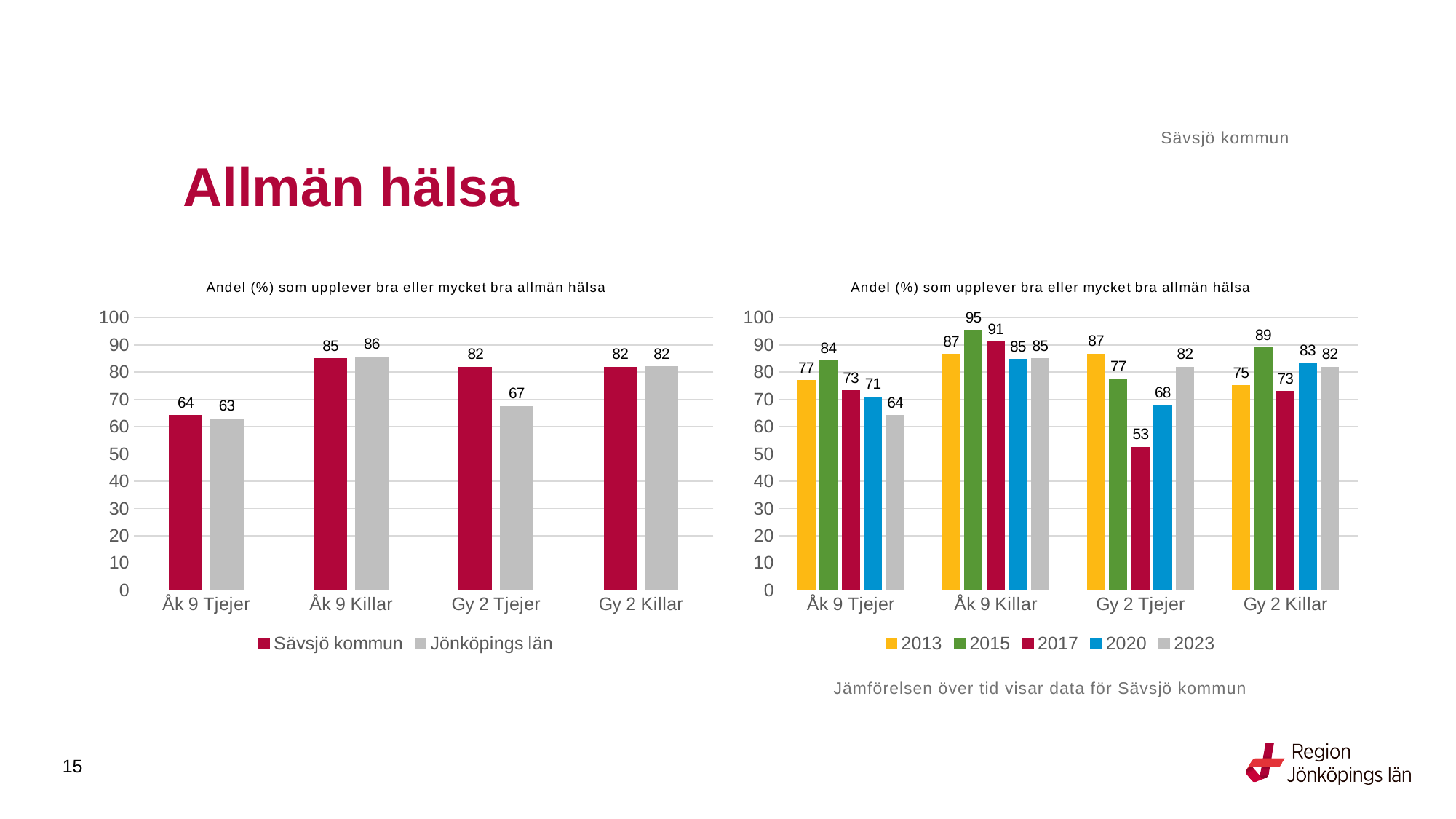
In the left chart, how many series does the legend list? 2 In the left chart, what is the value for Jönköpings län for Gy 2 Tjejer? 67 In the right chart, what is the difference between the 2013 and 2023 values for Gy 2 Tjejer? 5 In the left chart, which category has the lowest value for Sävsjö kommun? Åk 9 Tjejer In the right chart, what is the value for 2017 for Gy 2 Tjejer? 53 In the right chart, how many series does the legend list? 5 In the right chart, which is larger for Åk 9 Tjejer: the value for 2013 or the value for 2023? 2013 In the right chart, what is the value for 2015 for Åk 9 Killar? 95 What type of chart is the right chart? Bar chart In the right chart, which year has the highest value for Gy 2 Killar? 2015 In the left chart, what is the value for Sävsjö kommun for Åk 9 Tjejer? 64 In the left chart, what is the difference between Sävsjö kommun and Jönköpings län for Gy 2 Tjejer? 15